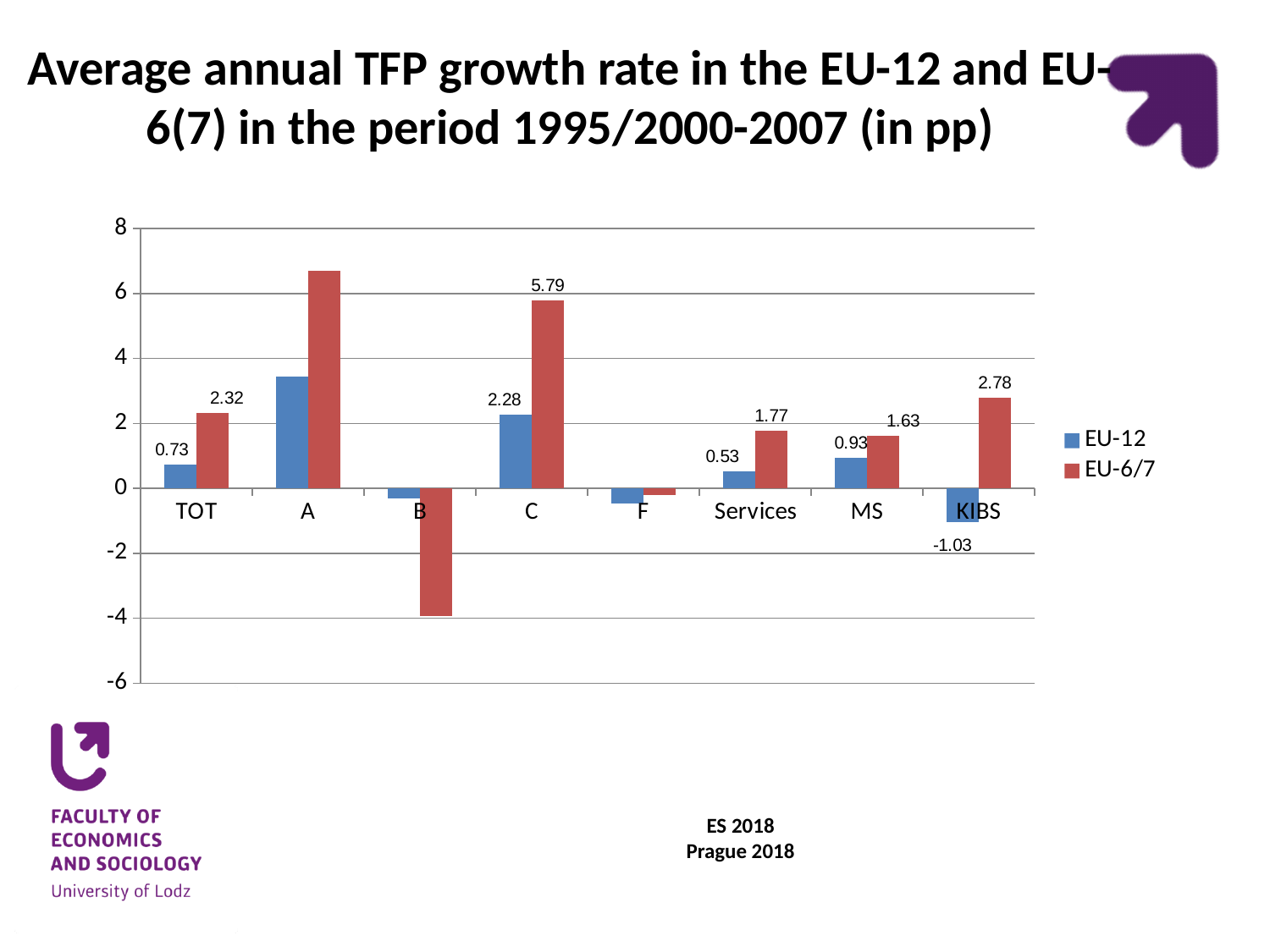
What is the value for EU-12 in the KIBS category? -1.03 What is the difference between the EU-6/7 and EU-12 values in the TOT category? 1.59 What is the value for EU-12 in the TOT category? 0.73 What is the difference between the EU-6/7 and EU-12 values in category C? 3.51 Is the EU-6/7 value for category B greater or less than -2? less Which category has the lowest EU-6/7 value? B How many categories are shown on the x axis? 8 What is the value for EU-6/7 in the Services category? 1.77 In the MS category, which series has the larger value, EU-12 or EU-6/7? EU-6/7 Is the EU-6/7 value for category A greater or less than 6? greater What is the value for EU-6/7 in category C? 5.79 How many series does the legend list? 2